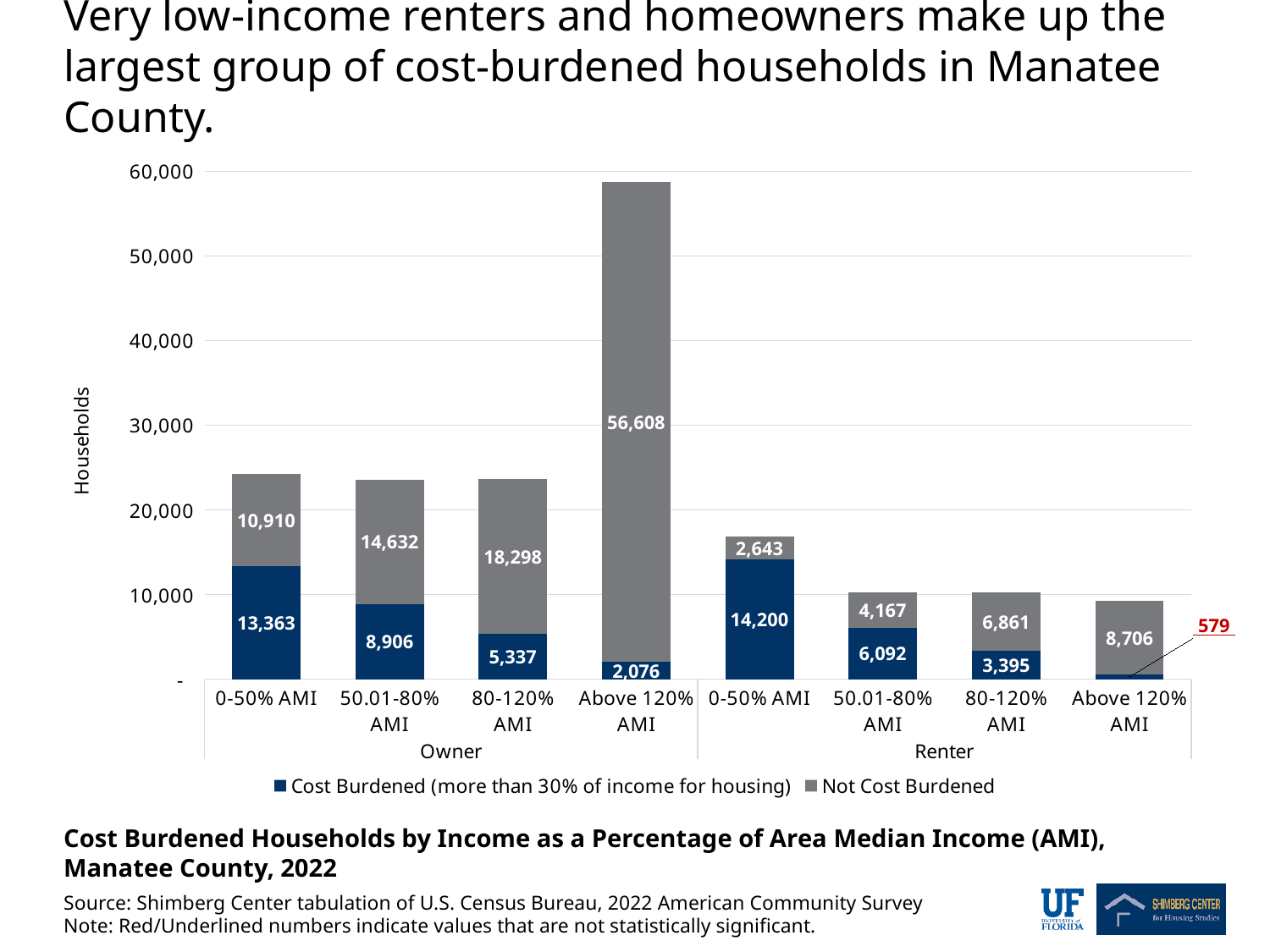
Which category has the highest number of cost-burdened households? Renter, 0-50% AMI What is the difference between cost-burdened renter households and cost-burdened owner households in the 0-50% AMI category? 837 What type of chart is shown on the slide? Stacked bar chart What is the number of cost-burdened renter households in the Above 120% AMI category? 579 What is the number of cost-burdened owner households in the 0-50% AMI category? 13,363 Which category has the lowest number of cost-burdened households? Renter, Above 120% AMI How many bars are shown in the chart? 8 What is the number of not cost-burdened owner households in the Above 120% AMI category? 56,608 Which is larger: the number of not cost-burdened owner households at 80-120% AMI or at 50.01-80% AMI? 80-120% AMI How many series does the legend list? 2 Is the total height of the Owner Above 120% AMI bar greater or less than 50,000? greater What is the total number of households in the Owner 0-50% AMI bar? 24,273